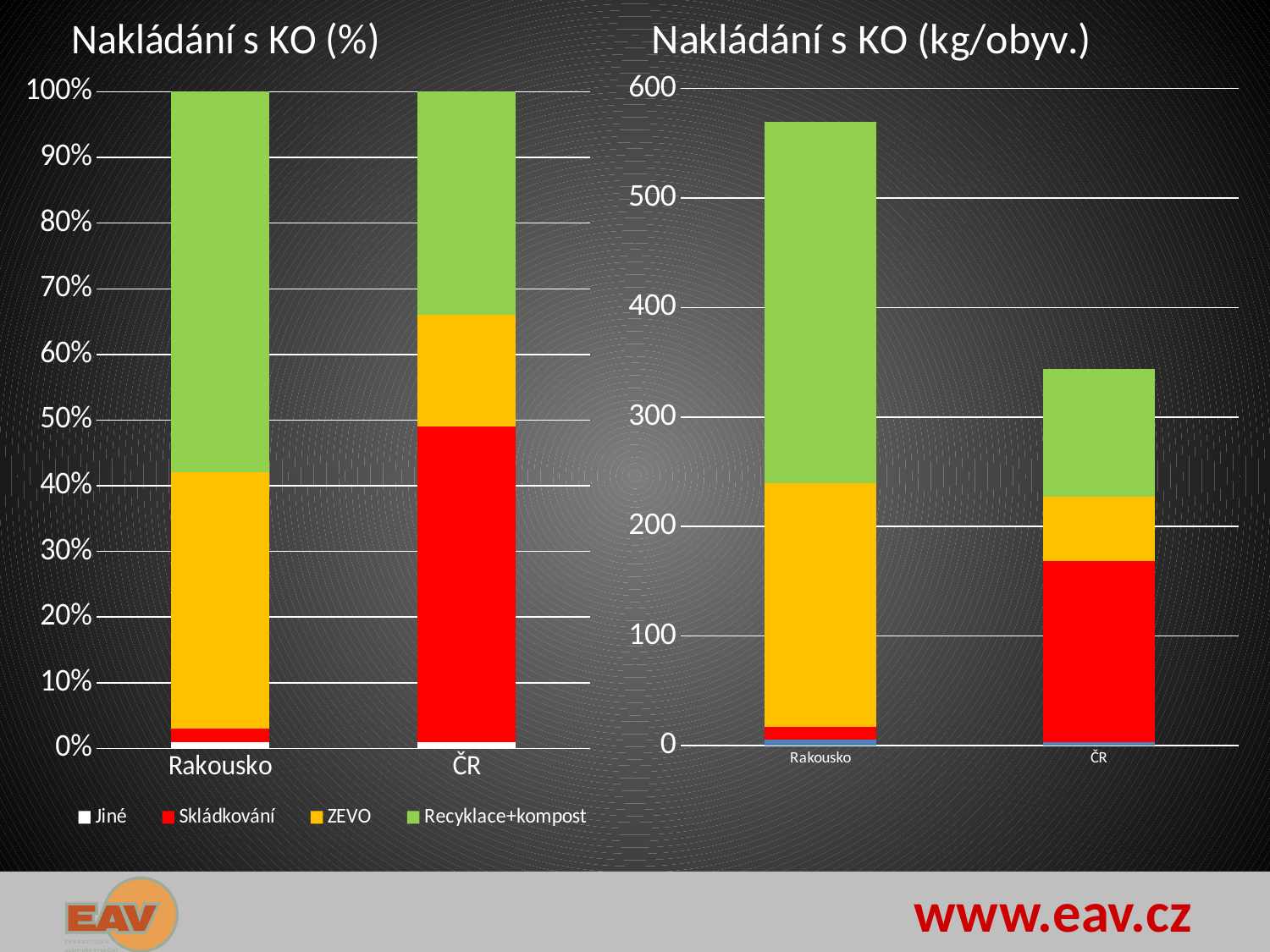
In the right chart "Nakládání s KO (kg/obyv.)", is the total height of the ČR bar greater or less than 400? less In the left chart "Nakládání s KO (%)", does the top of the ZEVO segment for ČR lie above or below the 60% line? above What is the title of the right chart on the slide? Nakládání s KO (kg/obyv.) In the left chart "Nakládání s KO (%)", which country has the larger Recyklace+kompost share, Rakousko or ČR? Rakousko How many categories are shown on the x axis of the right chart "Nakládání s KO (kg/obyv.)"? 2 In the left chart "Nakládání s KO (%)", is the Skládkování share for Rakousko greater or less than 10%? less Which legend entry in the left chart "Nakládání s KO (%)" is shown in green? Recyklace+kompost What type of chart is the left chart titled "Nakládání s KO (%)"? stacked bar chart How many series does the legend of the left chart "Nakládání s KO (%)" list? 4 In the right chart "Nakládání s KO (kg/obyv.)", which country has the taller total bar, Rakousko or ČR? Rakousko In the left chart "Nakládání s KO (%)", which country has the larger Skládkování share, Rakousko or ČR? ČR